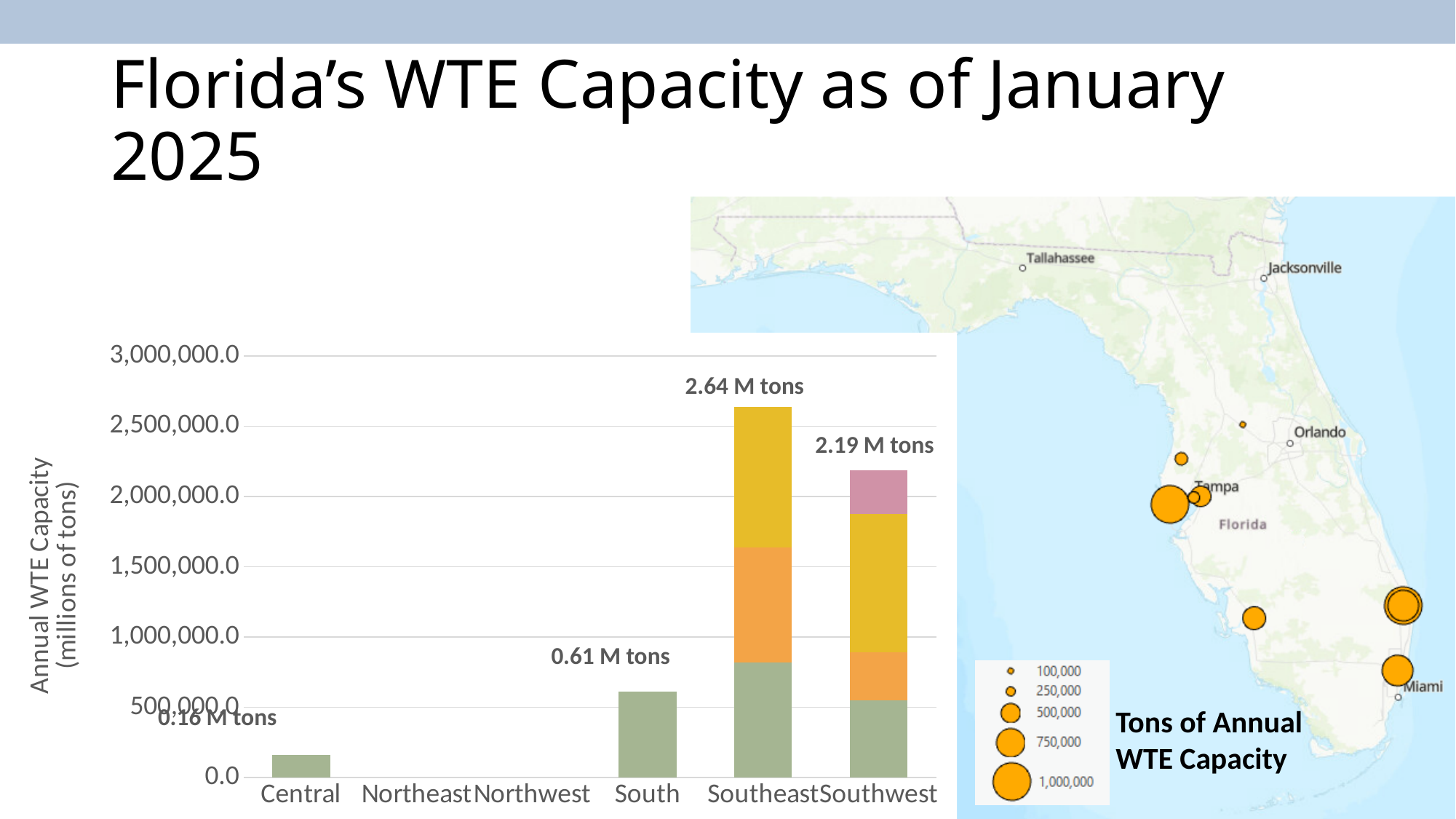
How many regions are listed on the x axis of the bar chart? 6 What kind of chart is used to show annual WTE capacity by region? Bar chart What is the labeled annual WTE capacity for the Central region? 0.16 M tons What is the difference between the labeled capacities of the South and Central regions? 0.45 M tons What is the difference between the labeled capacities of the Southeast and Southwest regions? 0.45 M tons Is the value for Southeast greater or less than 2,500,000.0? greater Which region has the highest annual WTE capacity in the bar chart? Southeast Which region has the larger annual WTE capacity, South or Central? South What is the labeled total annual WTE capacity for the Southwest region? 2.19 M tons What is the title of the vertical axis of the bar chart? Annual WTE Capacity (millions of tons) What is the labeled annual WTE capacity for the South region? 0.61 M tons What is the labeled total annual WTE capacity for the Southeast region? 2.64 M tons